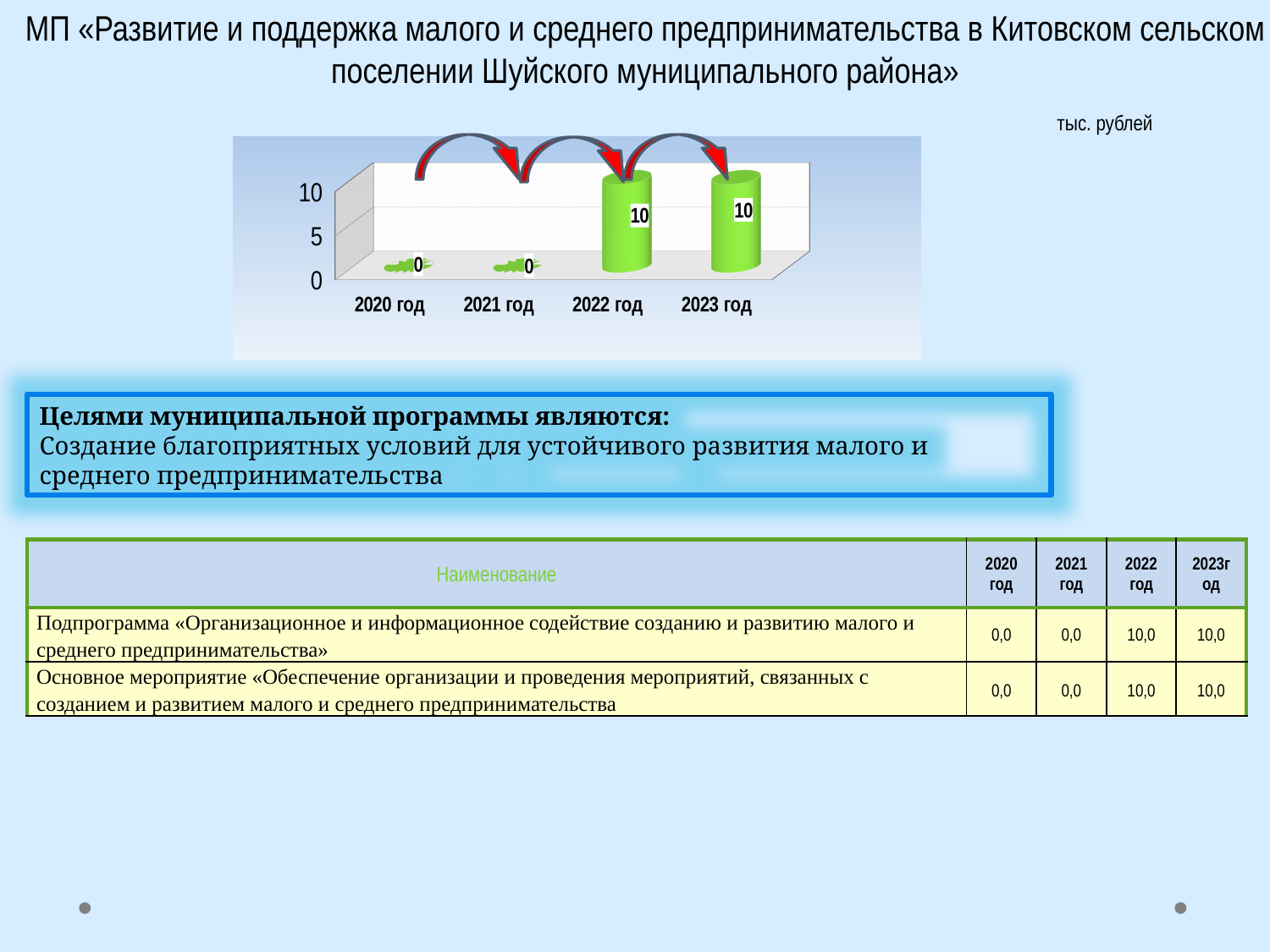
How many categories are shown on the x axis of the chart? 4 Do the values rise or fall from 2020 год to 2023 год? rise Is the value for 2022 год greater or less than 5? greater What unit of measurement is indicated for the chart? тыс. рублей What is the value for 2020 год on the chart? 0 What is the highest value shown on the chart's vertical axis? 10 Which is larger, the value for 2020 год or the value for 2023 год? 2023 год What is the difference between the values for 2022 год and 2021 год? 10 What kind of chart is shown on the slide? bar chart What is the value for 2021 год on the chart? 0 What is the value for 2022 год on the chart? 10 What is the value for 2023 год on the chart? 10